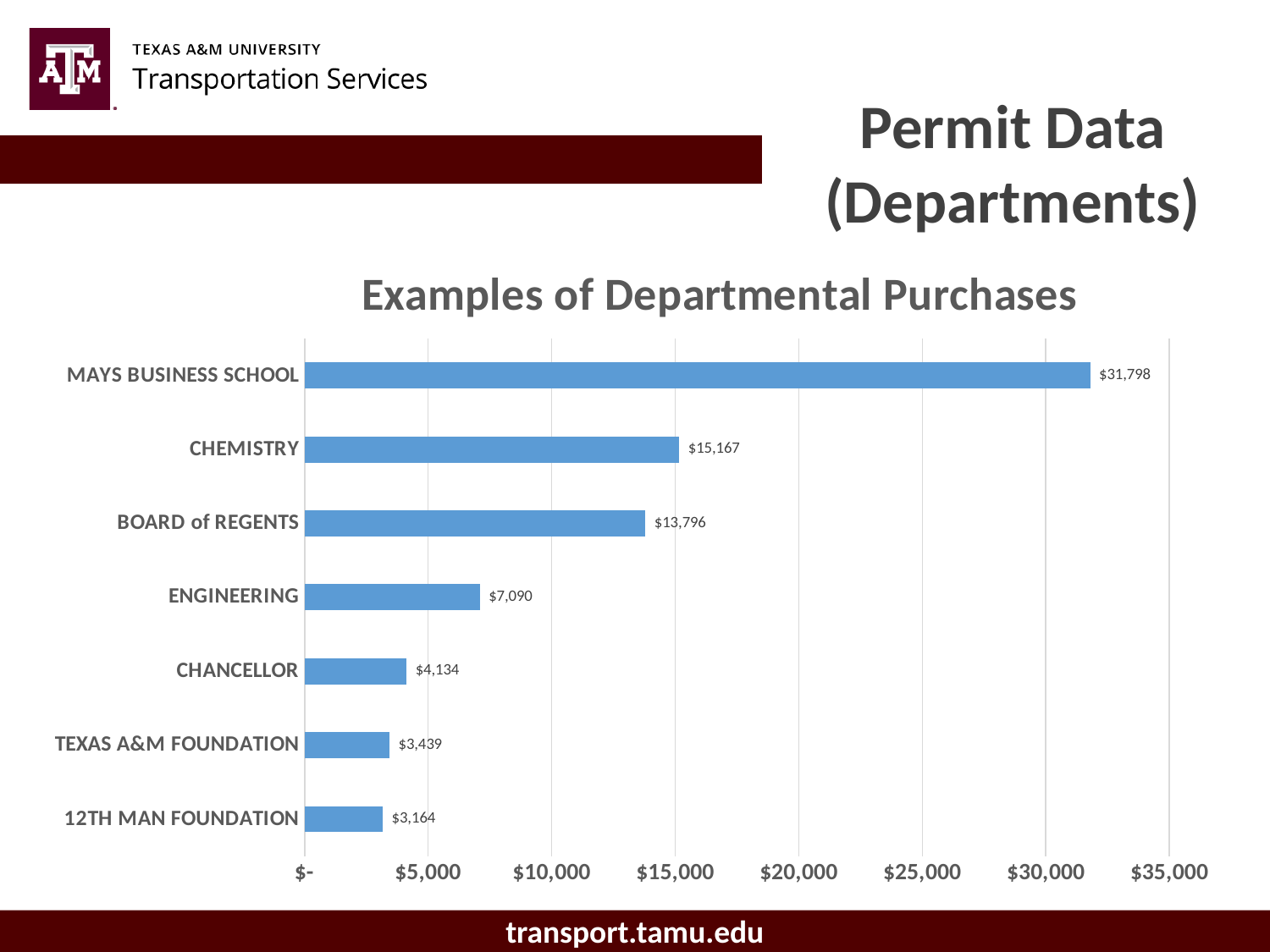
Is the value for BOARD of REGENTS greater or less than $15,000? less What is the value for 12TH MAN FOUNDATION? $3,164 What is the value for ENGINEERING? $7,090 What is the value for MAYS BUSINESS SCHOOL? $31,798 What is the value for CHEMISTRY? $15,167 Which department has the highest value? MAYS BUSINESS SCHOOL Which is larger, the value for CHANCELLOR or the value for TEXAS A&M FOUNDATION? CHANCELLOR What kind of chart is shown on the slide? bar chart Which department has the lowest value? 12TH MAN FOUNDATION What is the difference between the values for CHEMISTRY and BOARD of REGENTS? $1,371 What is the title of the chart? Examples of Departmental Purchases How many departments are shown in the chart? 7